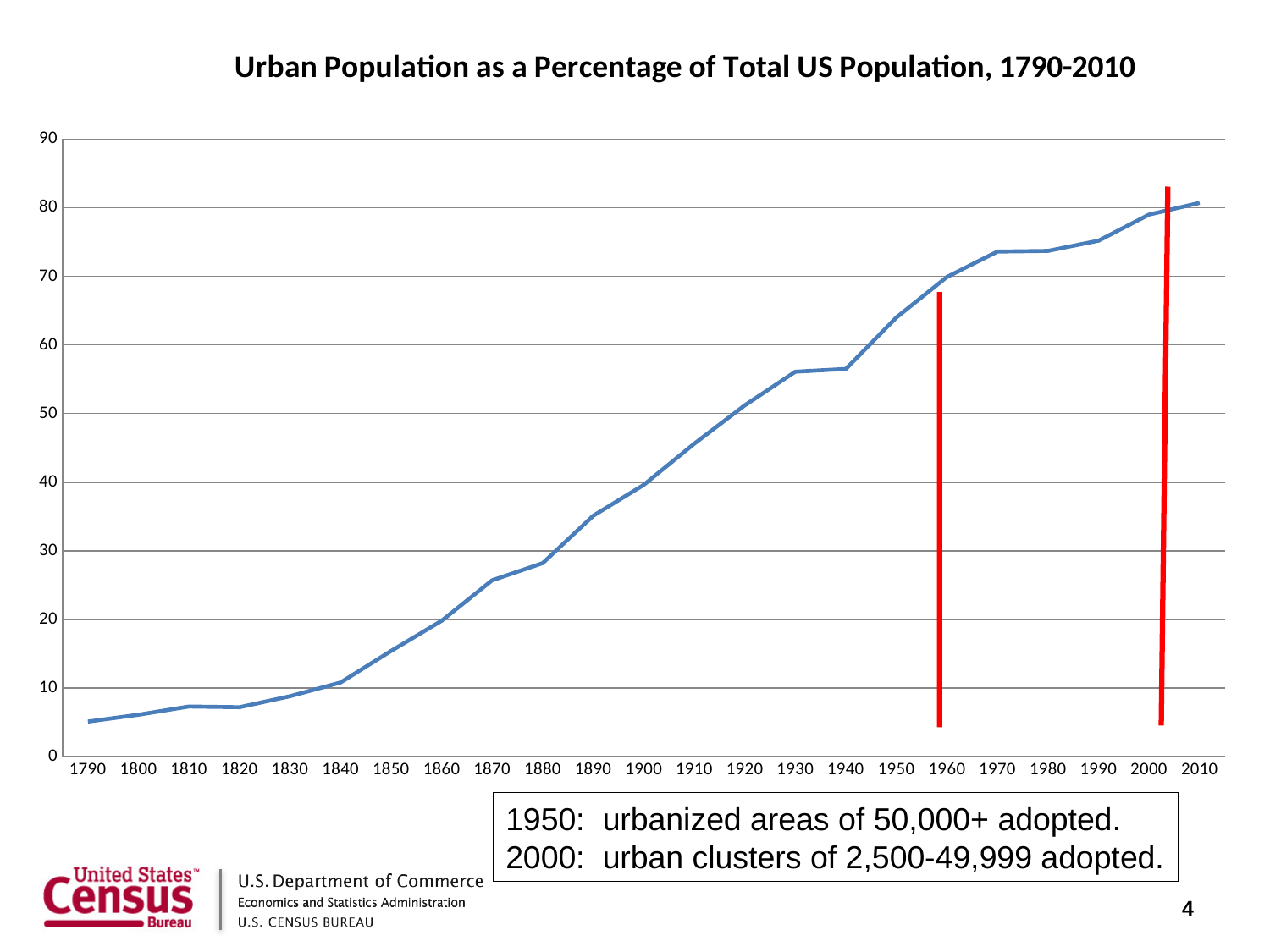
Is the value for 1790 greater or less than 10? less Is the value for 1880 greater or less than 30? less Which year has the lowest urban population percentage? 1790 Is the value for 1970 greater or less than 70? greater How many data points (decades) are plotted on the line? 23 Do the values generally rise or fall from 1790 to 2010? rise What is the title of the chart? Urban Population as a Percentage of Total US Population, 1790-2010 Which year has the highest urban population percentage? 2010 What kind of chart is shown on the slide? line chart Which year has the larger value, 1900 or 1950? 1950